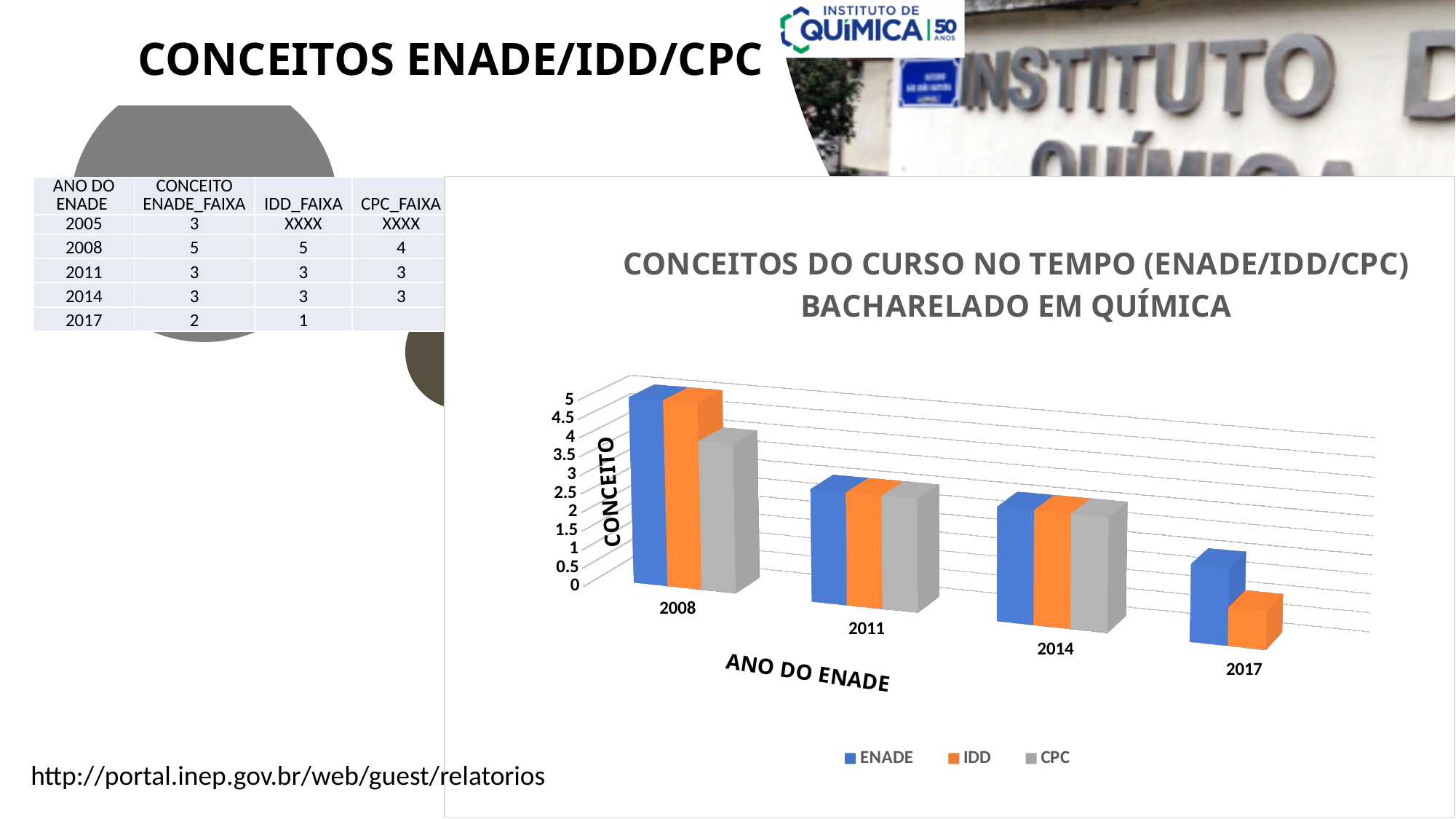
How many series does the chart legend list? 3 Which year has the lowest IDD value in the chart? 2017 Which series is shown in orange in the chart legend? IDD What is the ENADE value for 2008 in the chart? 5 What kind of chart is shown on the slide? bar chart Which is larger in the chart, the ENADE value for 2008 or the ENADE value for 2017? 2008 Do the ENADE values rise or fall from 2008 to 2017 in the chart? fall What is the CPC value for 2008 in the chart? 4 What is the difference between the ENADE value for 2008 and the ENADE value for 2011 in the chart? 2 What is the IDD value for 2017 in the chart? 1 Which year has the highest ENADE value in the chart? 2008 How many years are shown on the x axis of the chart? 4